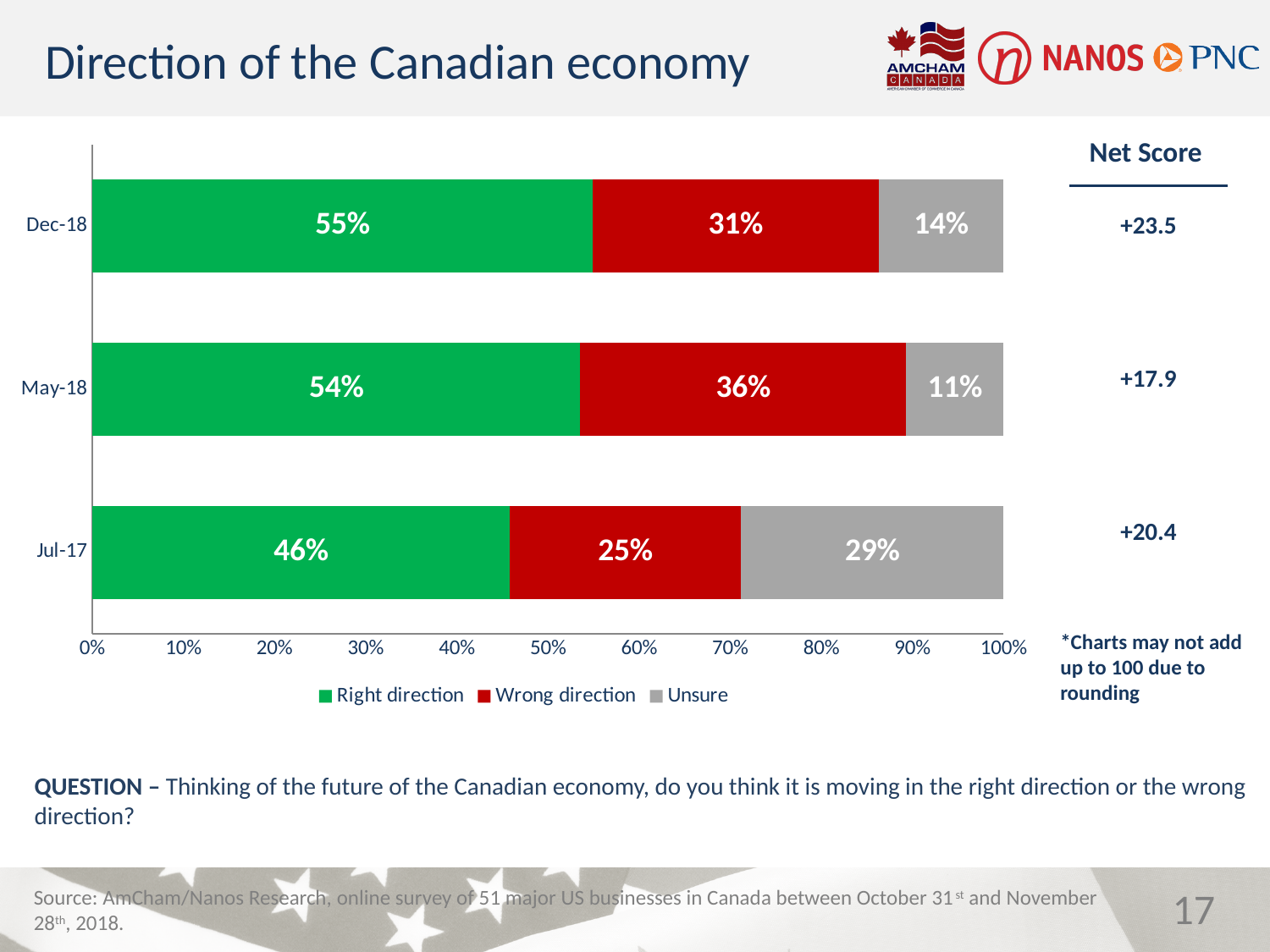
How many time periods are shown on the chart? 3 Which colour represents "Wrong direction" in the chart? Red What is the Net Score shown for May-18? +17.9 What kind of chart is shown on the slide? Stacked bar chart What percentage of respondents were "Unsure" in Jul-17? 29% Which period has the lowest "Unsure" percentage? May-18 How many series does the legend list? 3 What percentage of respondents said "Right direction" in Dec-18? 55% Which is larger: the "Unsure" share in Jul-17 or the "Wrong direction" share in Jul-17? Unsure Which period has the highest "Right direction" percentage? Dec-18 What is the difference between the "Wrong direction" percentages for May-18 and Jul-17? 11% What percentage of respondents said "Wrong direction" in May-18? 36%